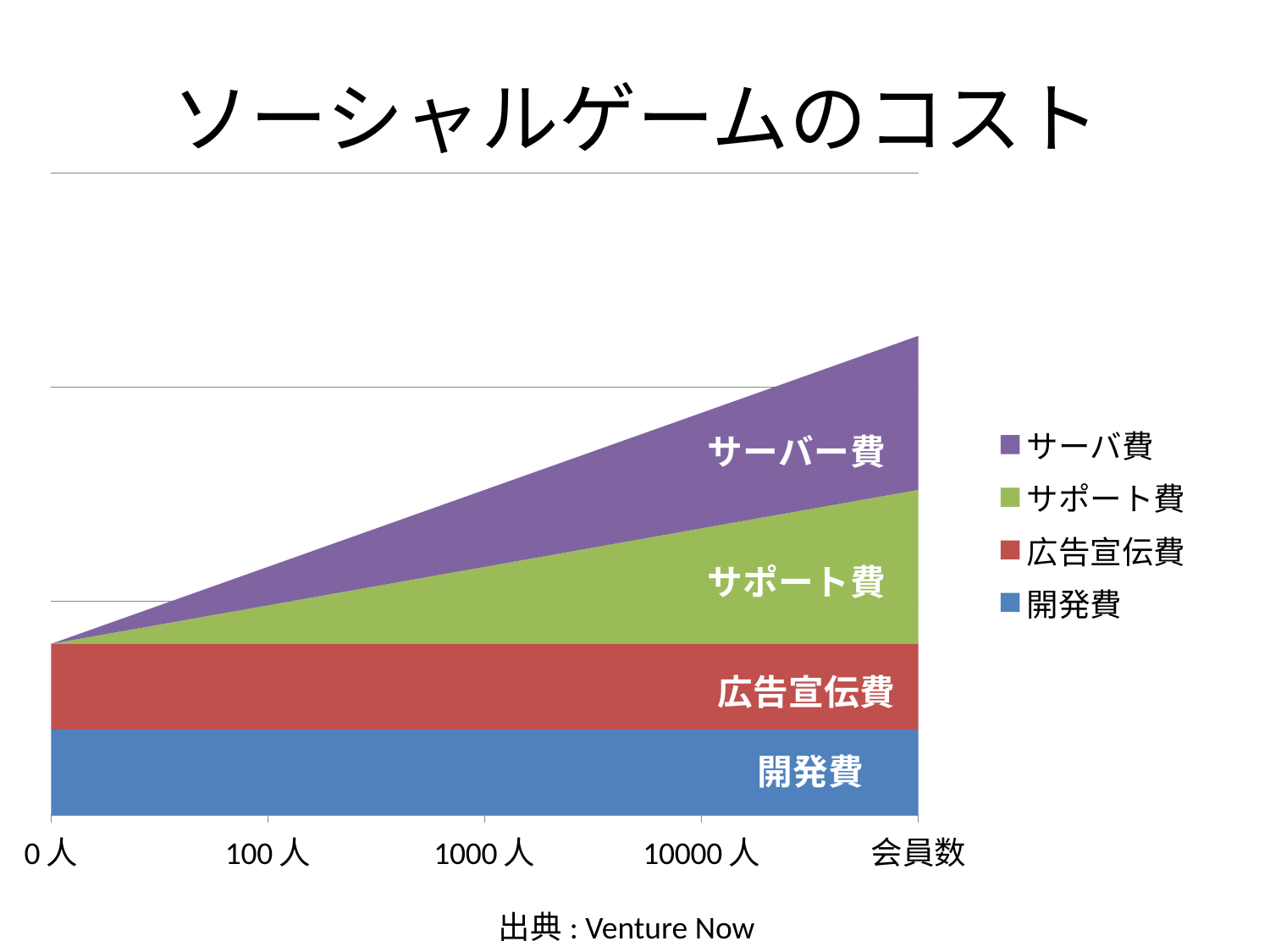
Which series is shown in purple in the legend? サーバ費 Which series is at the top of the stack? サーバー費 What kind of chart is shown on the slide? Stacked area chart At the right end of the chart (会員数), which band is thicker: サーバー費 or 開発費? サーバー費 Does the サーバー費 area grow or stay flat as the number of members increases along the x axis? Grows Which series is at the bottom of the stack? 開発費 What is the first x-axis label on the chart? 0人 How many series does the legend list? 4 How many tick labels are shown along the x axis? 5 Does the サポート費 area increase or decrease as membership increases? Increases Does the 開発費 area rise, fall, or stay flat along the x axis? Stays flat